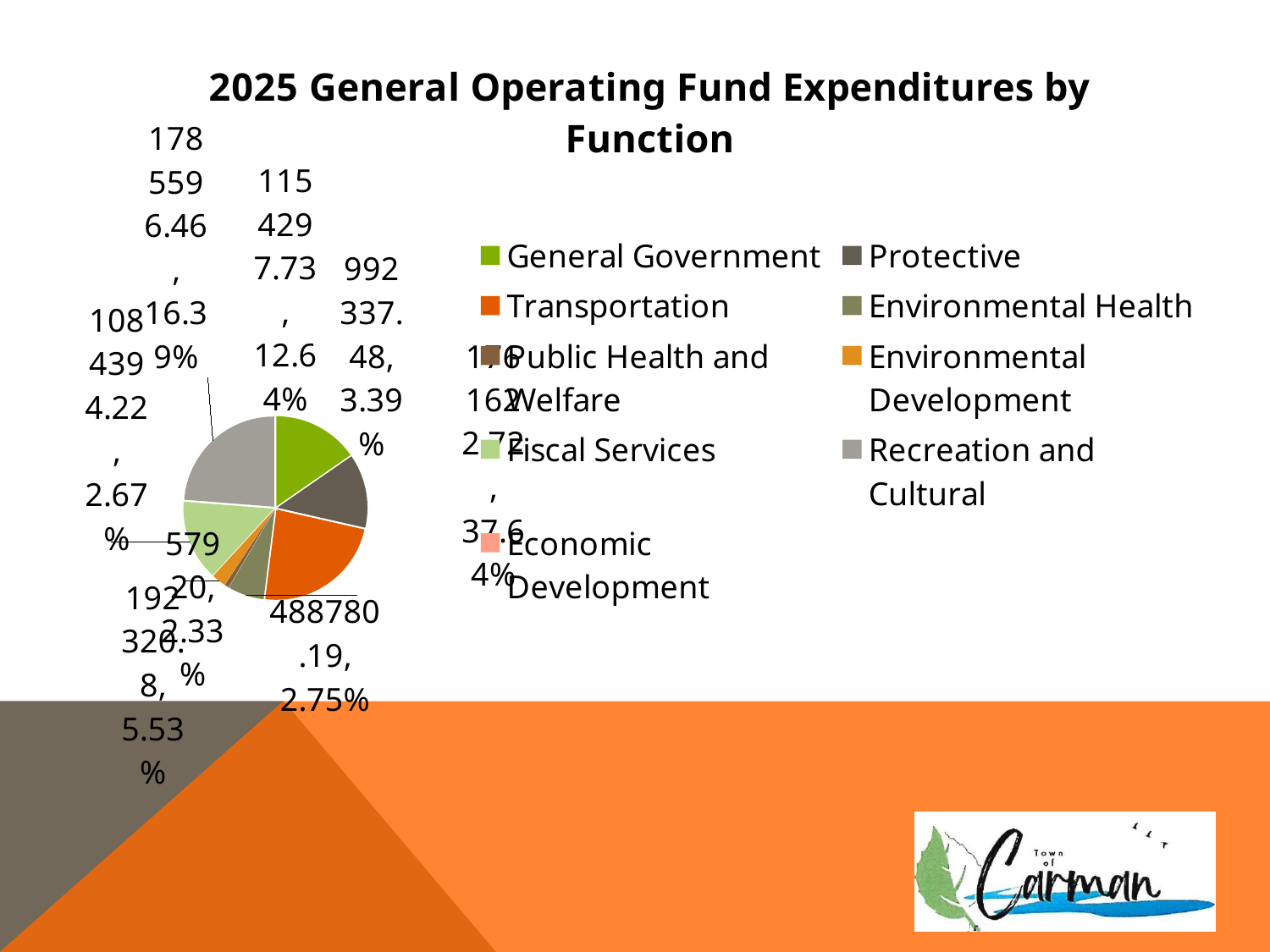
What kind of chart is shown on the slide? pie chart What colour is used for the General Government slice? green Which slice is larger, Recreation and Cultural or Environmental Development? Recreation and Cultural How many categories does the legend of the pie chart list? 9 Which slice is larger, Transportation or General Government? Transportation What is the title of the chart? 2025 General Operating Fund Expenditures by Function Which category has the largest slice of the pie? Recreation and Cultural